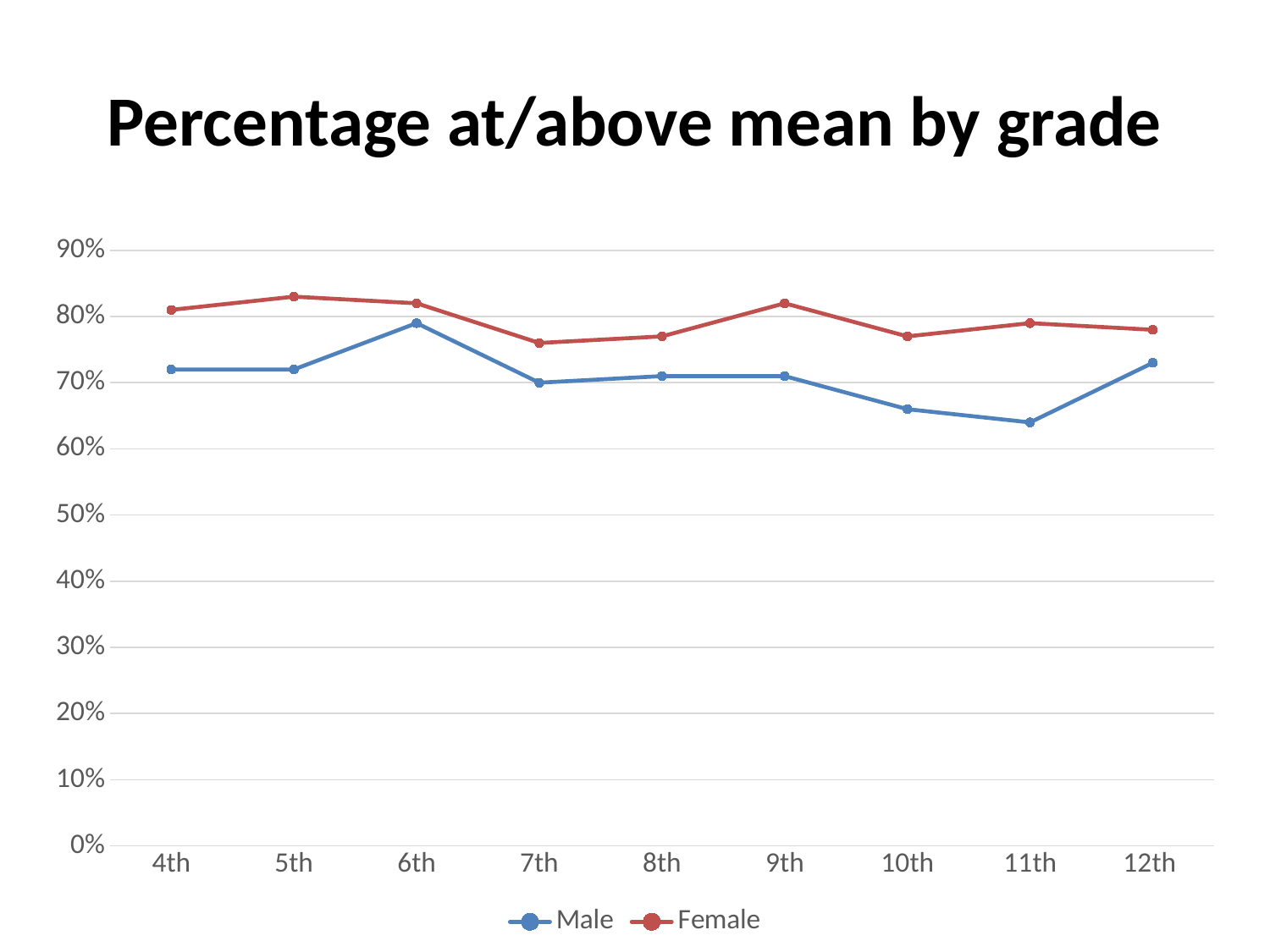
At 4th grade, which series has the higher value, Male or Female? Female For which grade is the Male series highest? 6th Is the Male value for 11th grade greater or less than 70%? less Is the Female value for 7th grade greater or less than 80%? less Is the Female value for 5th grade greater or less than 80%? greater What is the title of the chart? Percentage at/above mean by grade What type of chart is shown on the slide? line chart How many grade categories are shown on the x axis? 9 Which series is drawn in red? Female How many series does the legend list? 2 For the Male series, which is larger: the value at 6th grade or at 12th grade? 6th grade